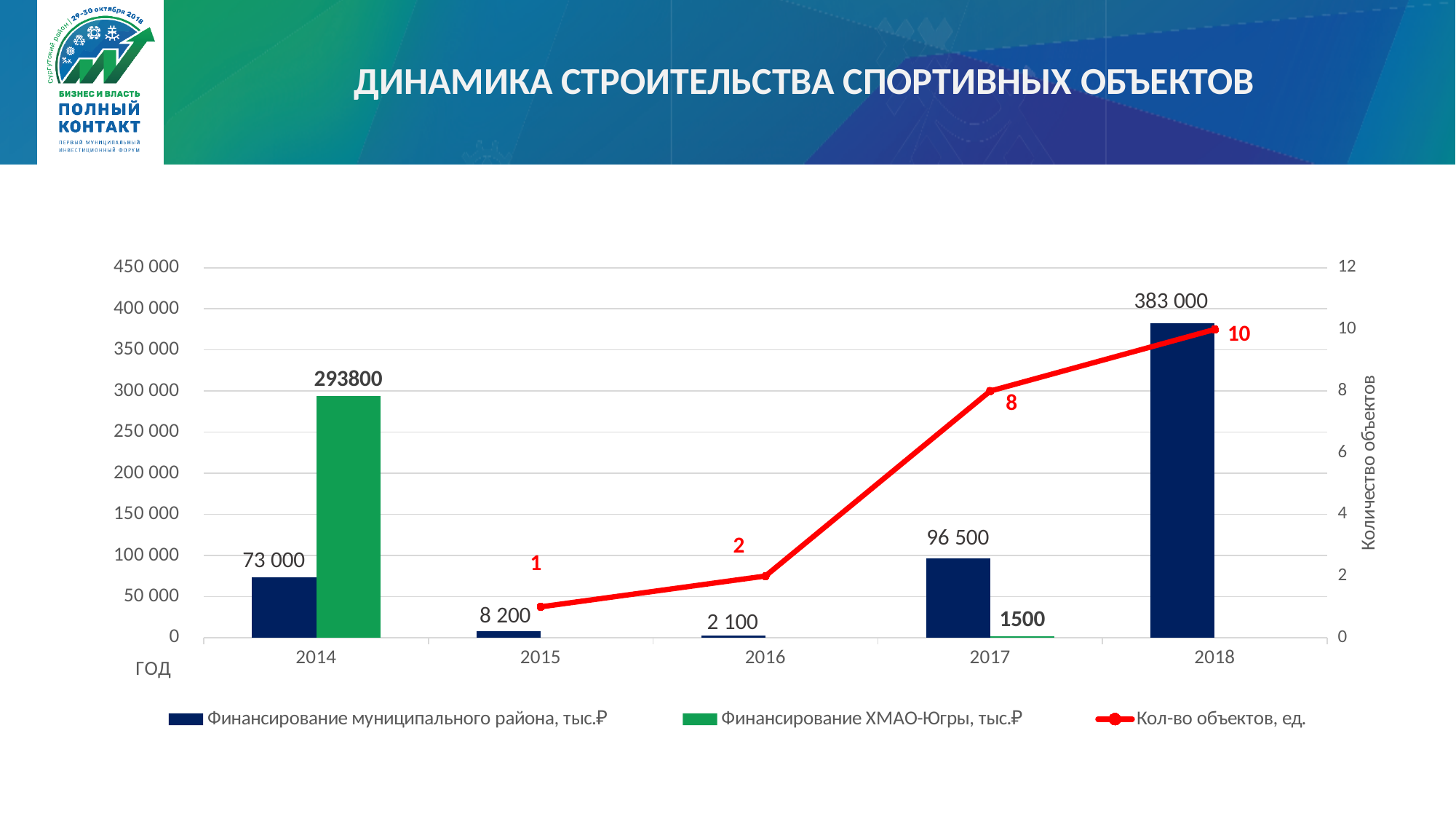
How many series does the legend list? 3 Does the Кол-во объектов, ед. line rise or fall from 2015 to 2018? rise Which year has the lowest value of Финансирование муниципального района, тыс.₽? 2016 Which is larger in 2014: Финансирование муниципального района, тыс.₽ or Финансирование ХМАО-Югры, тыс.₽? Финансирование ХМАО-Югры, тыс.₽ What is the title of the chart? ДИНАМИКА СТРОИТЕЛЬСТВА СПОРТИВНЫХ ОБЪЕКТОВ Which year has the highest value of Финансирование муниципального района, тыс.₽? 2018 What is the value of Финансирование муниципального района, тыс.₽ for 2016? 2 100 What is the value of Финансирование ХМАО-Югры, тыс.₽ for 2014? 293800 How many years are shown on the x axis? 5 What is the difference between Финансирование муниципального района, тыс.₽ in 2017 and in 2015? 88 300 What is the value of Финансирование муниципального района, тыс.₽ for 2018? 383 000 What is the value of Кол-во объектов, ед. for 2017? 8